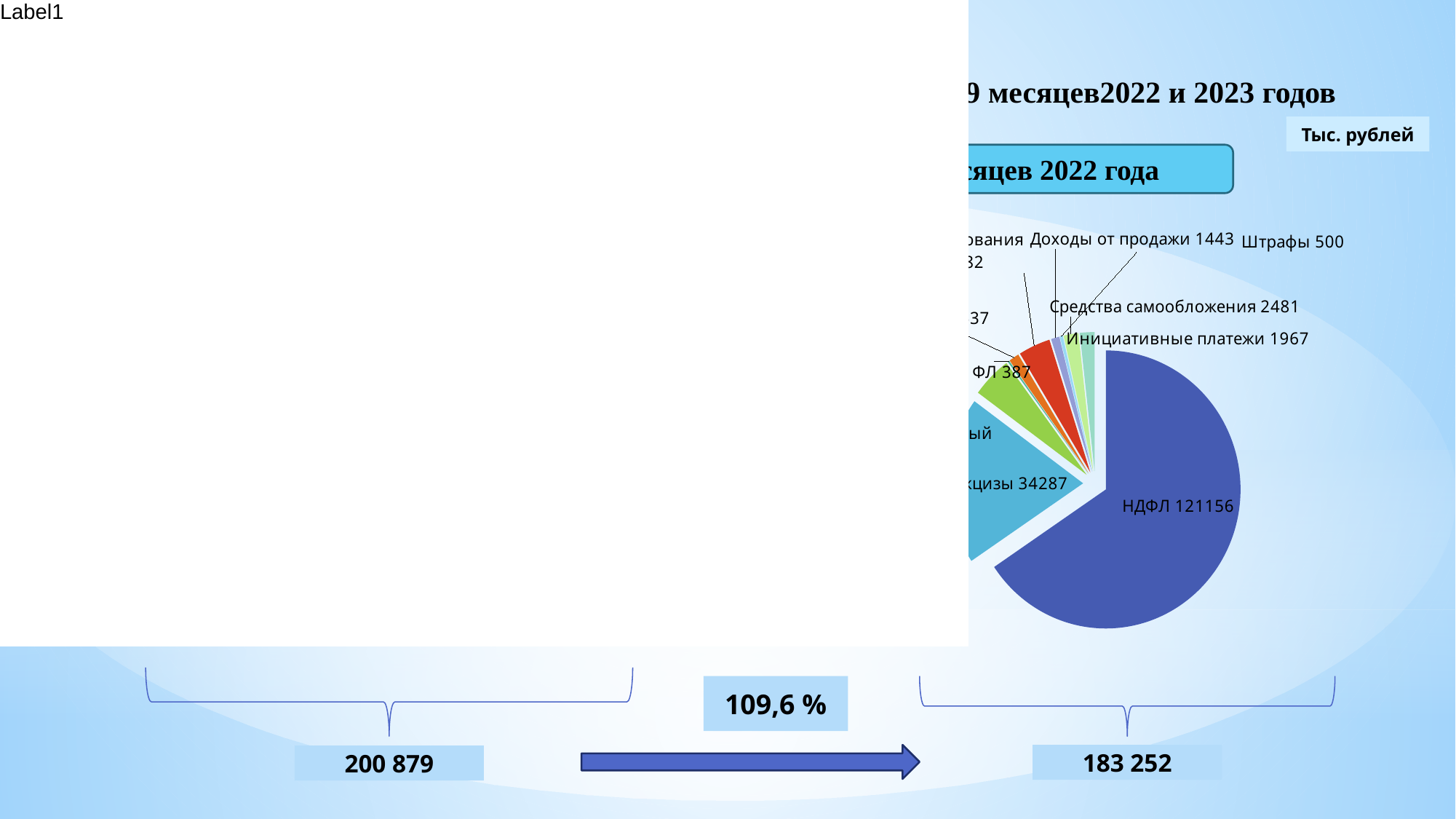
What is the difference between Доходы от продажи and Штрафы? 943 Which is larger, Доходы от продажи or Штрафы? Доходы от продажи What is the value for НДФЛ in the pie chart? 121156 Which is larger, Средства самообложения or Инициативные платежи? Средства самообложения What is the value for Штрафы in the pie chart? 500 What is the difference between Средства самообложения and Инициативные платежи? 514 What is the value for Средства самообложения in the pie chart? 2481 What is the value for Инициативные платежи in the pie chart? 1967 What kind of chart is shown on the slide? pie chart In what units are the values on the slide given? Тыс. рублей Which category has the largest slice in the pie chart? НДФЛ What is the value for Доходы от продажи in the pie chart? 1443